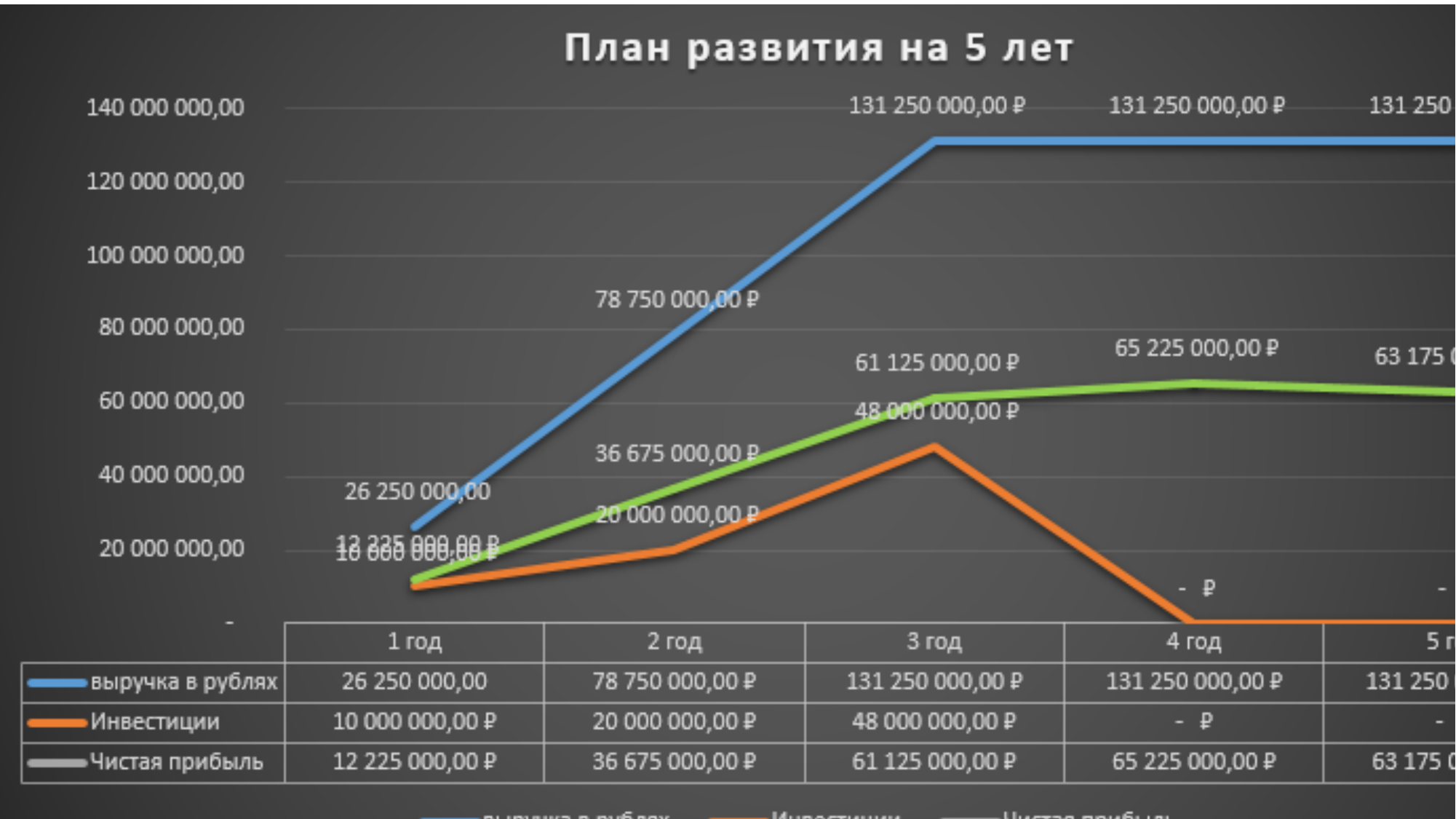
Which is larger in 2 год: Инвестиции or Чистая прибыль? Чистая прибыль What is the value of Инвестиции in 3 год? 48 000 000,00 ₽ How many series does the chart's legend list? 3 What is the title of the chart? План развития на 5 лет In which year is Инвестиции at its highest? 3 год Does выручка в рублях rise or fall from 1 год to 3 год? rise In which year is выручка в рублях at its lowest? 1 год What type of chart is shown on the slide? line chart What is the value of Чистая прибыль in 1 год? 12 225 000,00 ₽ What is the value of Чистая прибыль in 4 год? 65 225 000,00 ₽ What is the difference between выручка в рублях in 3 год and in 2 год? 52 500 000,00 ₽ What is the value of выручка в рублях in 2 год? 78 750 000,00 ₽